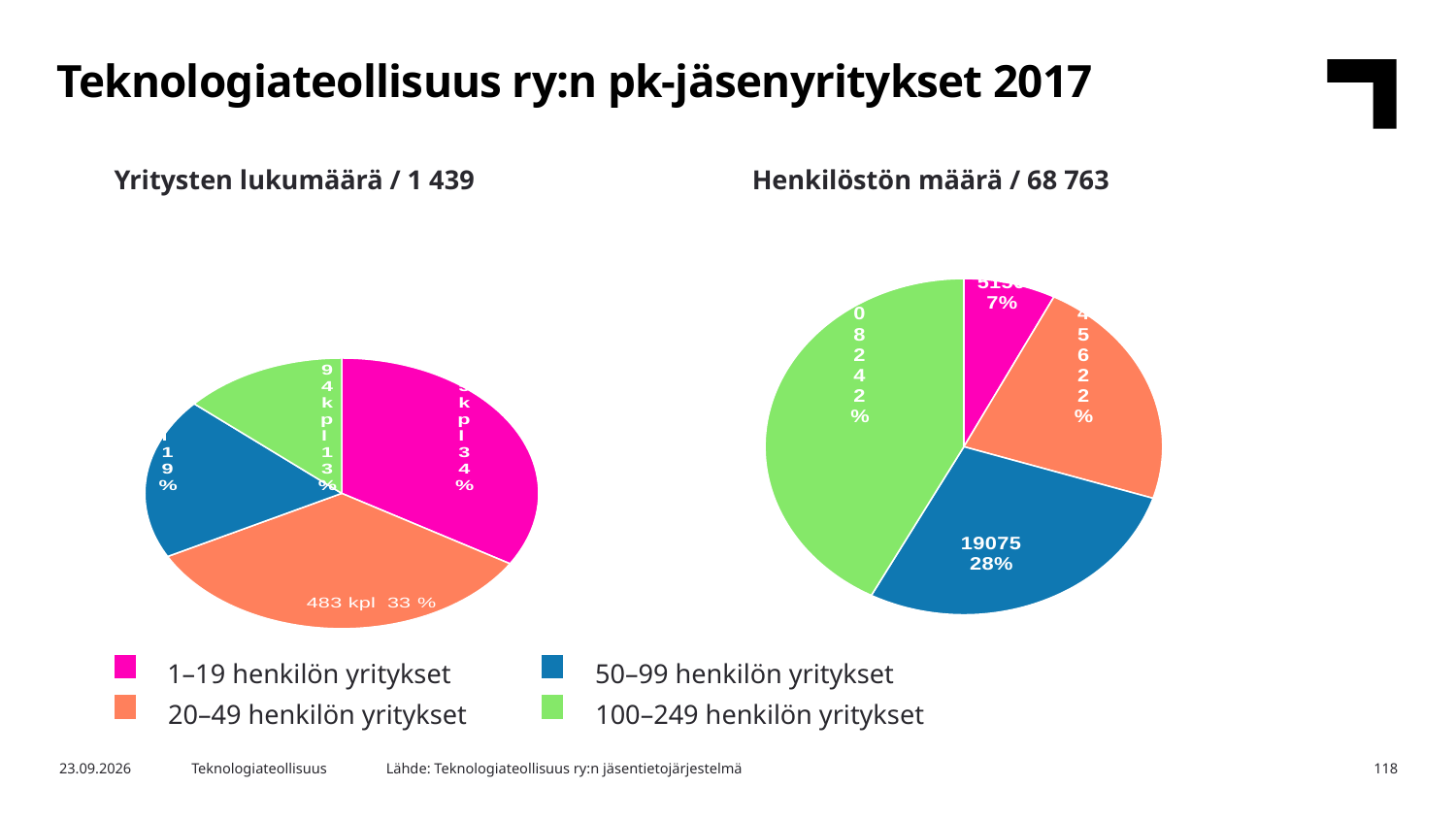
In the right pie chart (Henkilöstön määrä), which is larger: the share of 50–99 henkilön yritykset or the share of 1–19 henkilön yritykset? 50–99 henkilön yritykset In the right pie chart (Henkilöstön määrä), which category has the largest share? 100–249 henkilön yritykset In the left pie chart (Yritysten lukumäärä), how many companies are in the 20–49 henkilön yritykset category? 483 kpl In the left pie chart (Yritysten lukumäärä), what share do the 20–49 henkilön yritykset have? 33 % In the right pie chart (Henkilöstön määrä), what share do the 1–19 henkilön yritykset have? 7% In the left pie chart (Yritysten lukumäärä), what is the difference in percentage points between the 1–19 henkilön yritykset share (34 %) and the 100–249 henkilön yritykset share (13 %)? 21 percentage points In the left pie chart (Yritysten lukumäärä), which category has the smallest share? 100–249 henkilön yritykset In the left pie chart (Yritysten lukumäärä), what share do the 100–249 henkilön yritykset have? 13 % In the right pie chart (Henkilöstön määrä), how many personnel are in the 50–99 henkilön yritykset category? 19075 How many categories does the legend list? 4 How many slices does the left pie chart (Yritysten lukumäärä) have? 4 What kind of charts are shown on the slide? Pie charts